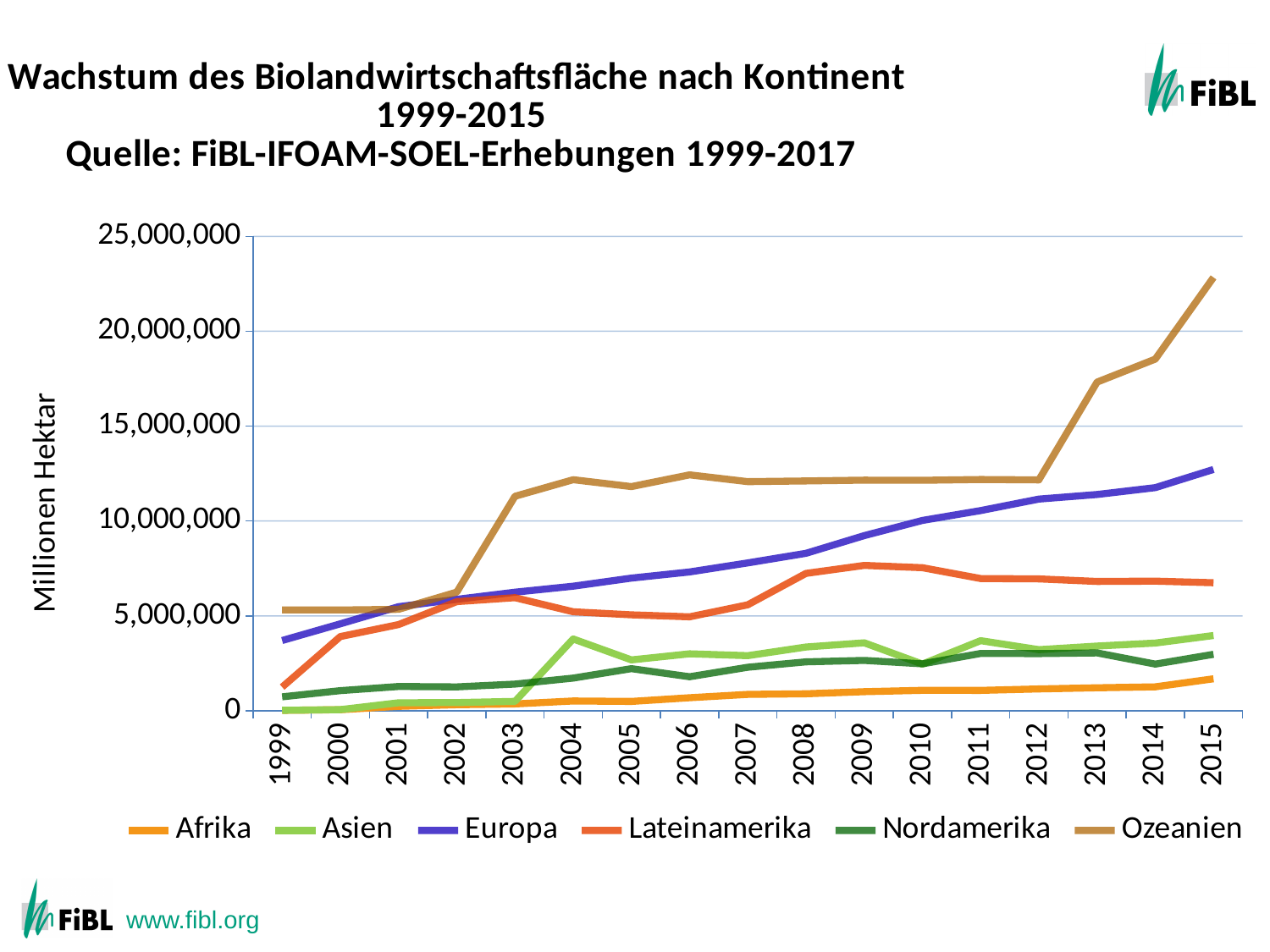
How many years are plotted along the x axis? 17 In 2015, which is larger: the value for Europa or the value for Lateinamerika? Europa Does the value for Europa rise or fall from 1999 to 2015? rise What kind of chart is shown on the slide? Line chart How many series does the legend list? 6 Which continent has the highest value in 2015? Ozeanien Is the value for Ozeanien in 2015 greater or less than 20,000,000? greater What is the label on the y axis? Millionen Hektar Is the value for Afrika in 2015 greater or less than 5,000,000? less Which continent has the lowest value in 2015? Afrika Is the value for Europa in 2015 greater or less than 10,000,000? greater